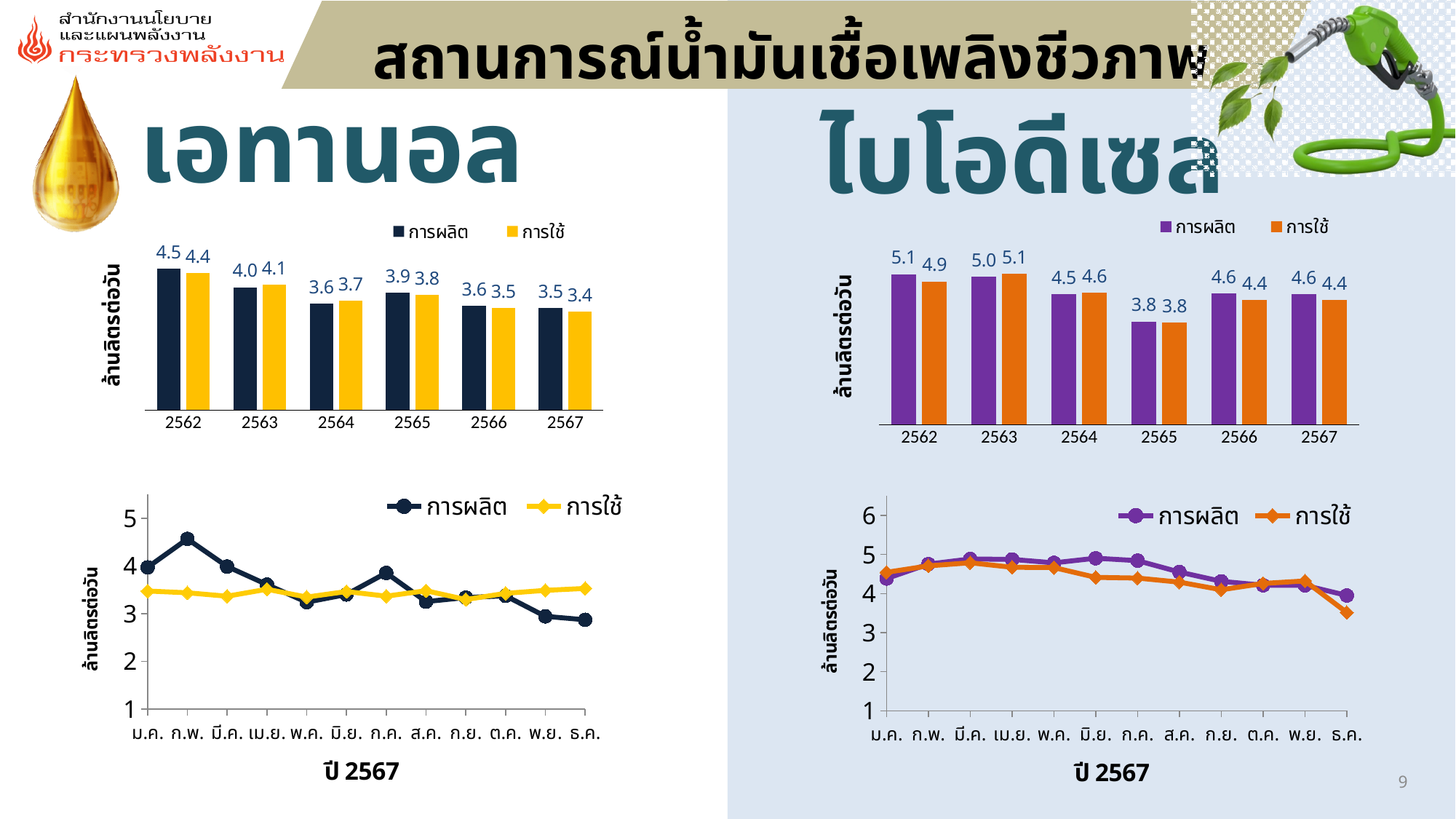
How many series does the legend of the biodiesel line chart (bottom right) list? 2 What kind of chart is the bottom right chart for biodiesel (ปี 2567)? line chart In the biodiesel bar chart (top right), what is the value of การใช้ for 2563? 5.1 In the biodiesel bar chart (top right), which year has the lowest การผลิต value? 2565 In the biodiesel bar chart (top right), what is the difference between การผลิต in 2562 and การผลิต in 2565? 1.3 In the ethanol bar chart (top left), what is the value of การผลิต for 2562? 4.5 In the ethanol bar chart (top left), which year has the highest การผลิต value? 2562 In the ethanol bar chart (top left), what is the value of การใช้ for 2567? 3.4 In the ethanol line chart (bottom left), is the การผลิต value for ธ.ค. greater or less than 3? less How many years are shown on the x axis of the ethanol bar chart (top left)? 6 In the biodiesel bar chart (top right), is การผลิต or การใช้ larger in 2566? การผลิต In the ethanol bar chart (top left), what is the difference between การผลิต and การใช้ in 2563? 0.1